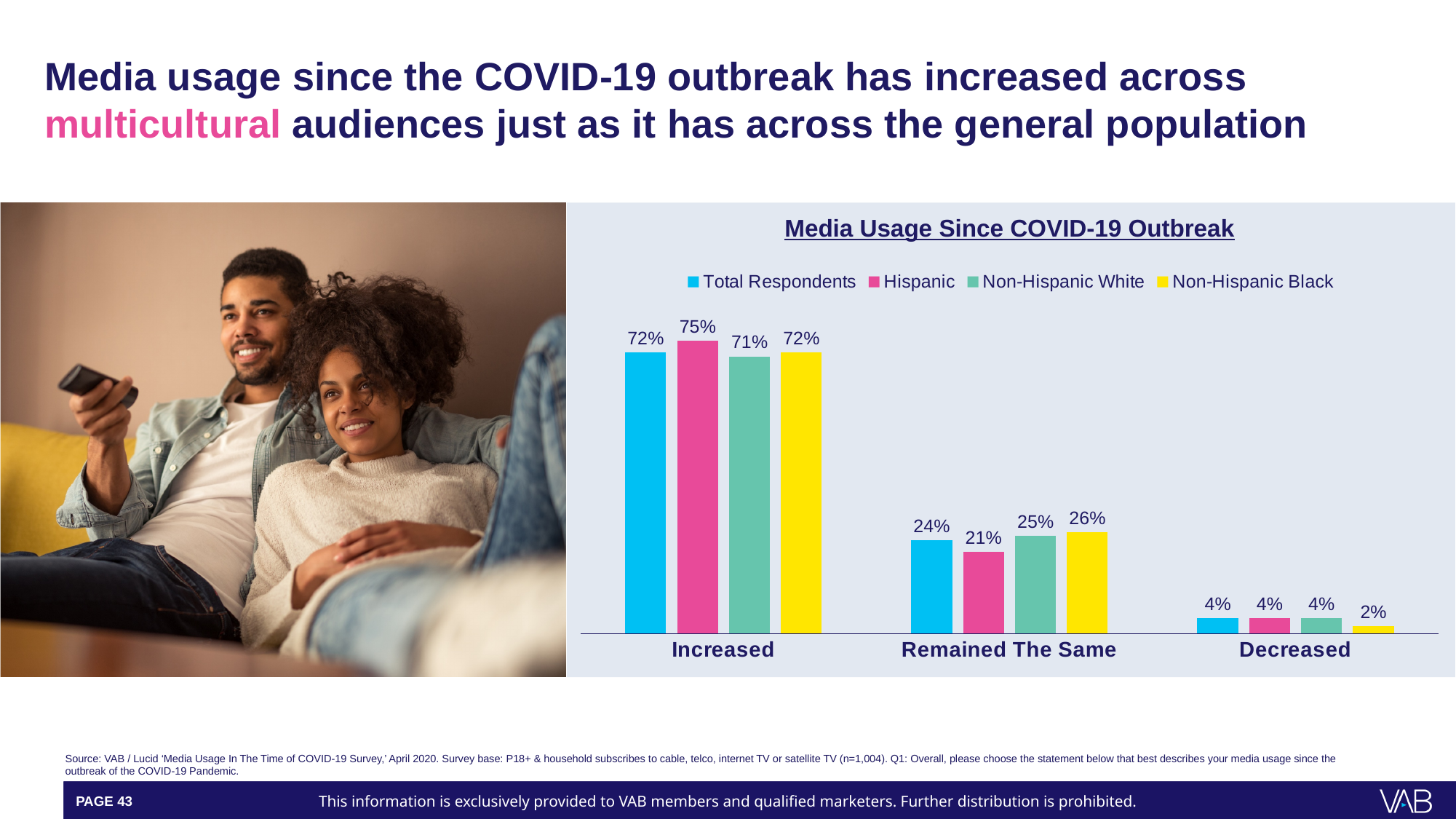
What percentage of Non-Hispanic Black respondents said their media usage remained the same? 26% Which series has the highest value in the Increased category? Hispanic Which series has the lowest value in the Remained The Same category? Hispanic What percentage of Hispanic respondents said their media usage increased? 75% What percentage of Total Respondents said their media usage decreased? 4% How many series does the legend list? 4 What is the title of the chart? Media Usage Since COVID-19 Outbreak What is the difference between the Hispanic and Non-Hispanic White values in the Increased category? 4% What kind of chart is shown on the slide? bar chart Do the values for Total Respondents rise or fall from Increased to Decreased along the x axis? fall In the Remained The Same category, is the value for Non-Hispanic White larger or smaller than the value for Hispanic? larger How many categories are shown on the x axis? 3